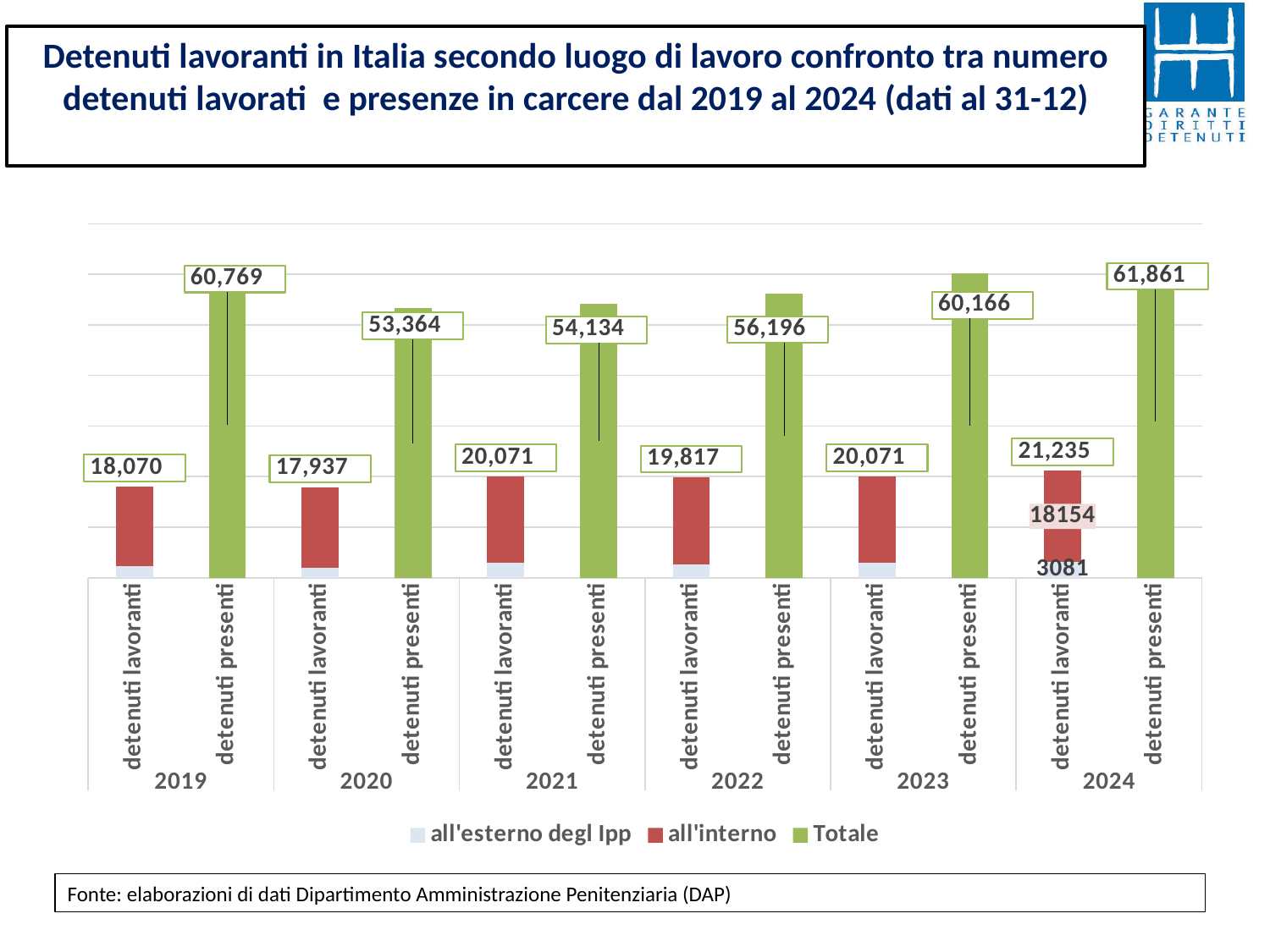
What is the value of the all'interno segment for detenuti lavoranti in 2024? 18154 What is the value shown for detenuti presenti in 2022? 56,196 What is the difference between detenuti presenti in 2024 and in 2019? 1,092 What is the value shown for detenuti lavoranti in 2021? 20,071 What kind of chart is shown on the slide? Bar chart In which year is the detenuti presenti bar the highest? 2024 What is the value shown for detenuti presenti in 2019? 60,769 What is the total of the stacked detenuti lavoranti bar in 2024? 21,235 Which year has the larger value for detenuti lavoranti, 2022 or 2023? 2023 How many years are shown on the x axis? 6 In which year is the detenuti presenti bar the lowest? 2020 How many series does the legend list? 3